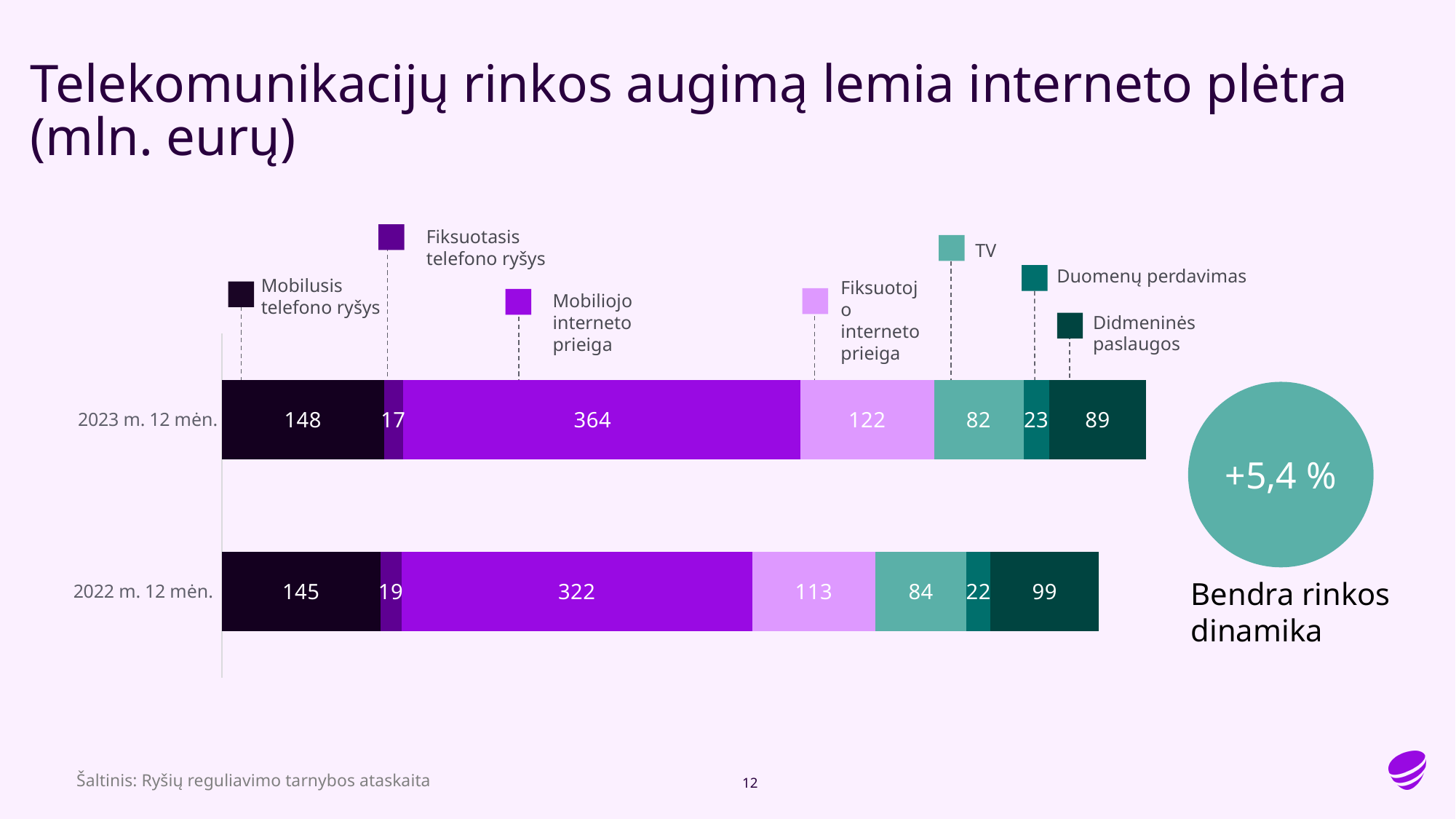
What is the total of the 2022 m. 12 mėn. stacked bar? 804 How many bars (periods) are shown in the chart? 2 Which is larger: TV in 2022 m. 12 mėn. or TV in 2023 m. 12 mėn.? TV in 2022 m. 12 mėn. By how much did Mobiliojo interneto prieiga change from 2022 m. 12 mėn. to 2023 m. 12 mėn.? 42 What is the total of the 2023 m. 12 mėn. stacked bar? 845 What is the value for Didmeninės paslaugos in 2023 m. 12 mėn.? 89 What is the value for Fiksuotojo interneto prieiga in 2022 m. 12 mėn.? 113 How many series does the legend list? 7 What type of chart is shown on the slide? Stacked bar chart What is the value for Mobiliojo interneto prieiga in 2023 m. 12 mėn.? 364 Which segment is the largest in the 2022 m. 12 mėn. bar? Mobiliojo interneto prieiga Which segment is the smallest in the 2023 m. 12 mėn. bar? Fiksuotasis telefono ryšys